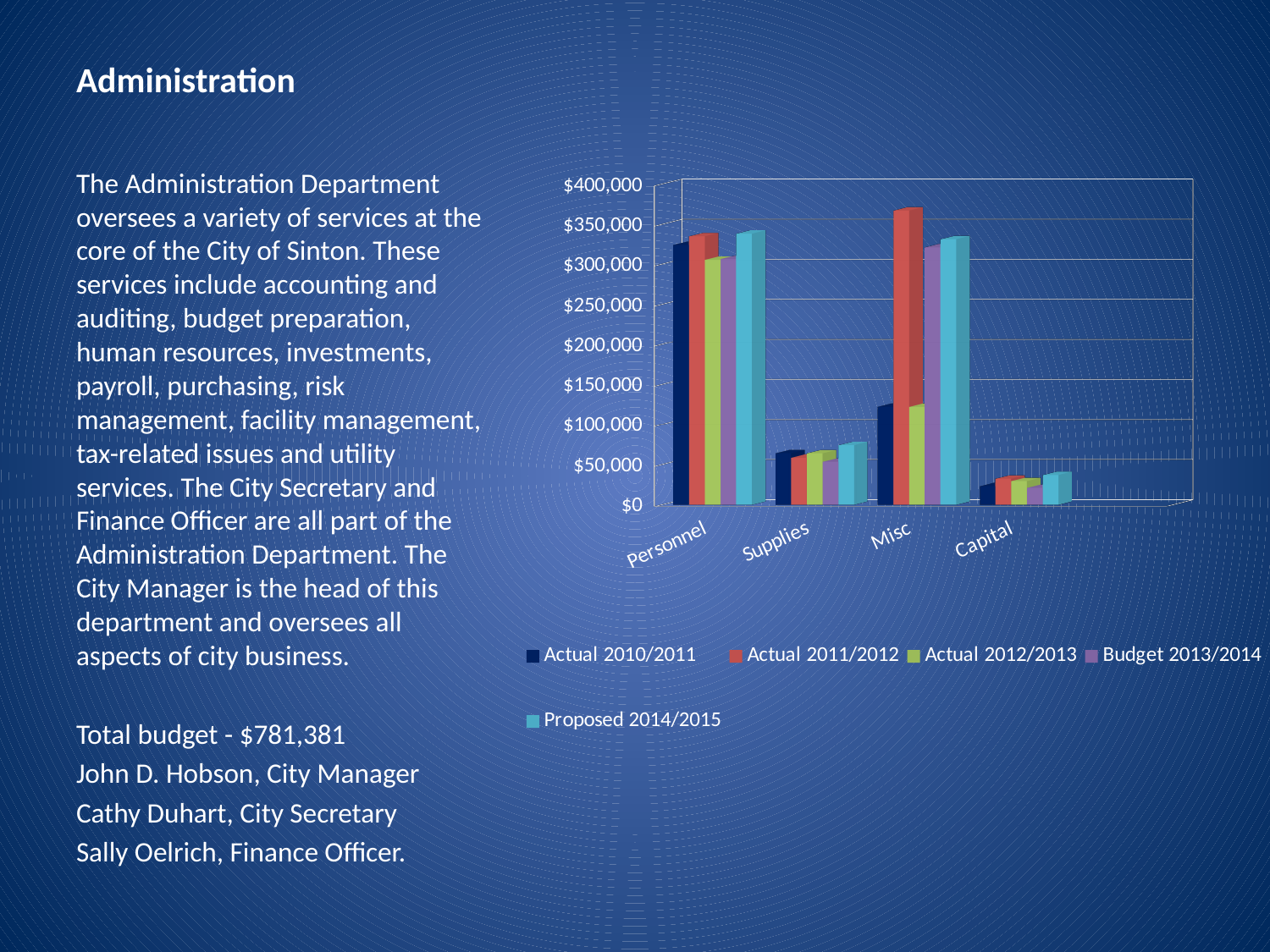
Which category has the lowest values across all series in the chart? Capital How many categories are shown on the x axis of the chart? 4 Is the Actual 2012/2013 value for Misc greater or less than $100,000? greater How many series does the chart legend list? 5 Is the Actual 2011/2012 value for Misc greater or less than $350,000? greater What is the last legend entry listed for the chart? Proposed 2014/2015 For Personnel, which is larger: the Actual 2011/2012 value or the Actual 2012/2013 value? Actual 2011/2012 In the Misc category, which series has the highest bar? Actual 2011/2012 Is the Actual 2010/2011 value for Personnel greater or less than $300,000? greater For Misc, which is larger: the Actual 2010/2011 value or the Actual 2011/2012 value? Actual 2011/2012 What kind of chart is shown on the slide? Bar chart